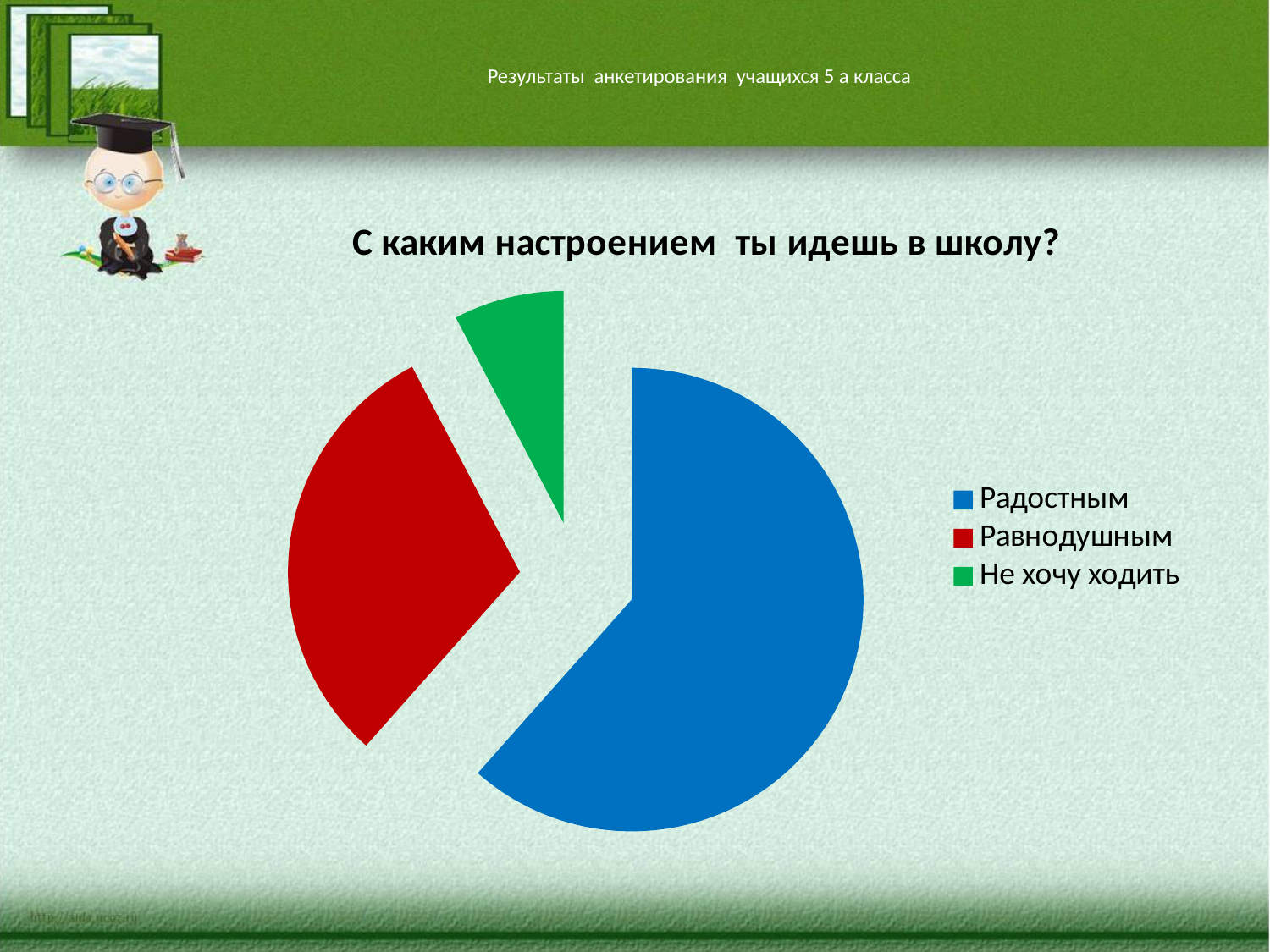
How many categories (slices) does the pie chart have? 3 Which category is shown in red? Равнодушным What kind of chart is shown on the slide? pie chart What is the title of the chart? С каким настроением ты идешь в школу? Which category has the smallest slice of the pie? Не хочу ходить Which category has the largest slice of the pie? Радостным Which slice is larger, Равнодушным or Не хочу ходить? Равнодушным Which colour represents the category Не хочу ходить? green Which category is shown in blue? Радостным How many entries does the legend list? 3 Which slice is larger, Радостным or Равнодушным? Радостным